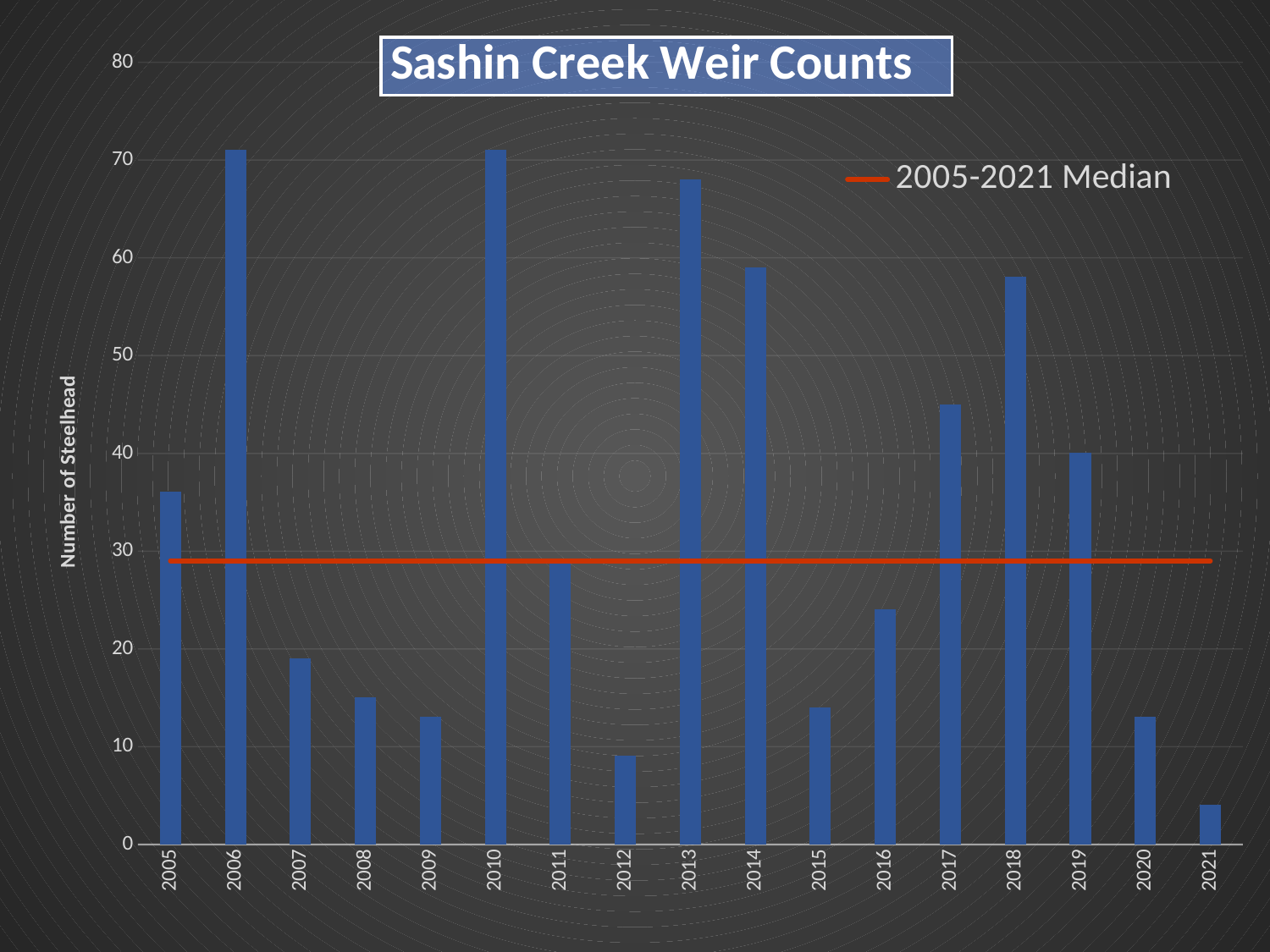
Is the value for 2007 greater or less than 20? less Is the value for 2005 greater or less than 30? greater Is the value for 2012 greater or less than 10? less Which year has the larger weir count, 2005 or 2007? 2005 Which year has the larger weir count, 2013 or 2014? 2013 What kind of chart is shown on the slide? bar chart Which year has the lowest weir count? 2021 How many years are shown along the x axis? 17 What is the title of the chart? Sashin Creek Weir Counts What is the label on the vertical axis? Number of Steelhead